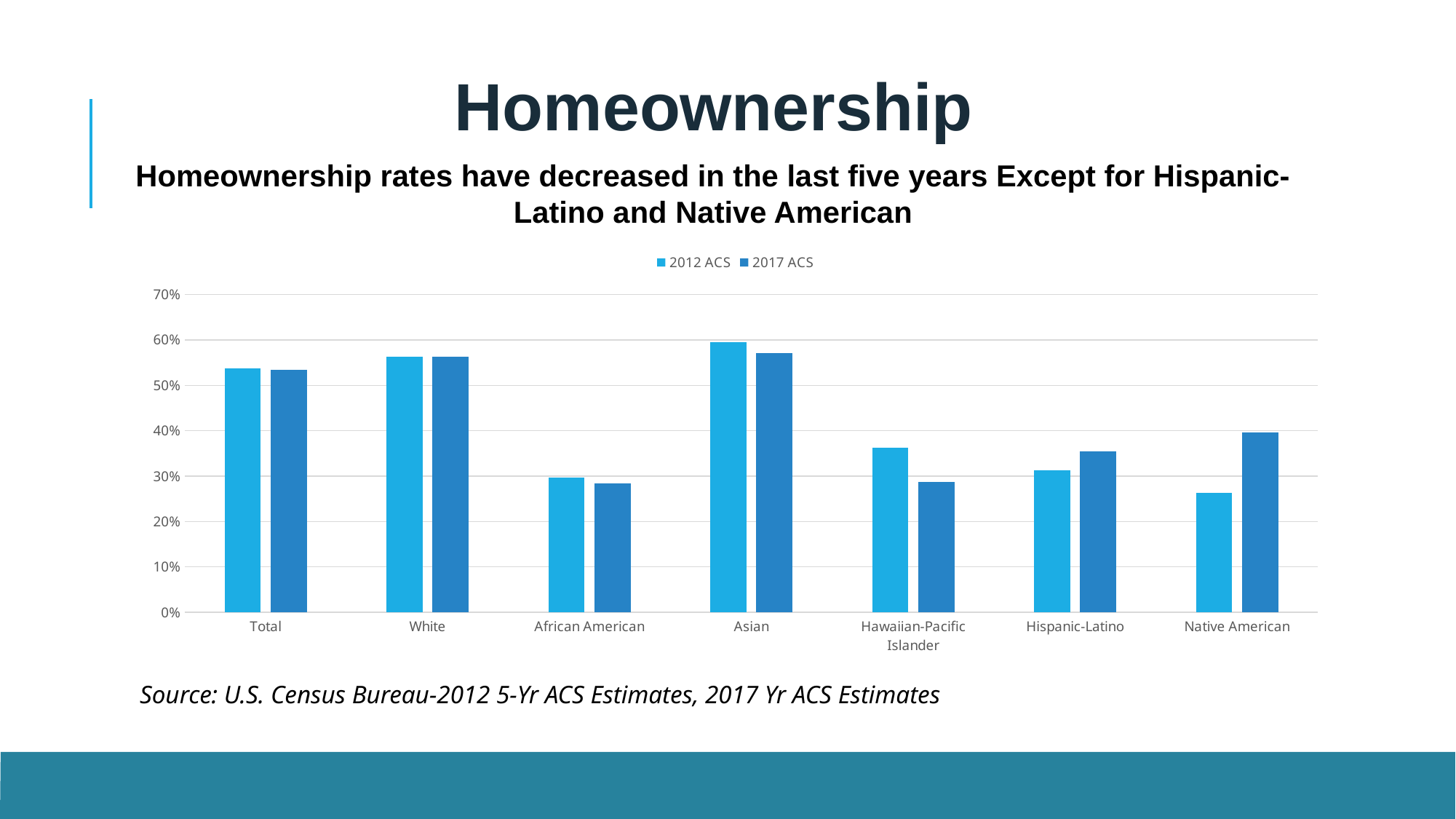
For Hawaiian-Pacific Islander, which is larger: the 2012 ACS value or the 2017 ACS value? 2012 ACS Which category has the highest 2012 ACS homeownership rate? Asian Which category has the lowest 2012 ACS homeownership rate? Native American How many categories are shown on the x axis? 7 How many series does the legend list? 2 What kind of chart is shown on the slide? bar chart Is the 2012 ACS value for Asian greater or less than 50%? greater For Native American, which is larger: the 2012 ACS value or the 2017 ACS value? 2017 ACS What are the two series named in the legend? 2012 ACS and 2017 ACS Is the 2017 ACS value for Hispanic-Latino greater or less than 30%? greater Is the 2012 ACS value for Native American greater or less than 30%? less What is the highest value shown on the y axis? 70%